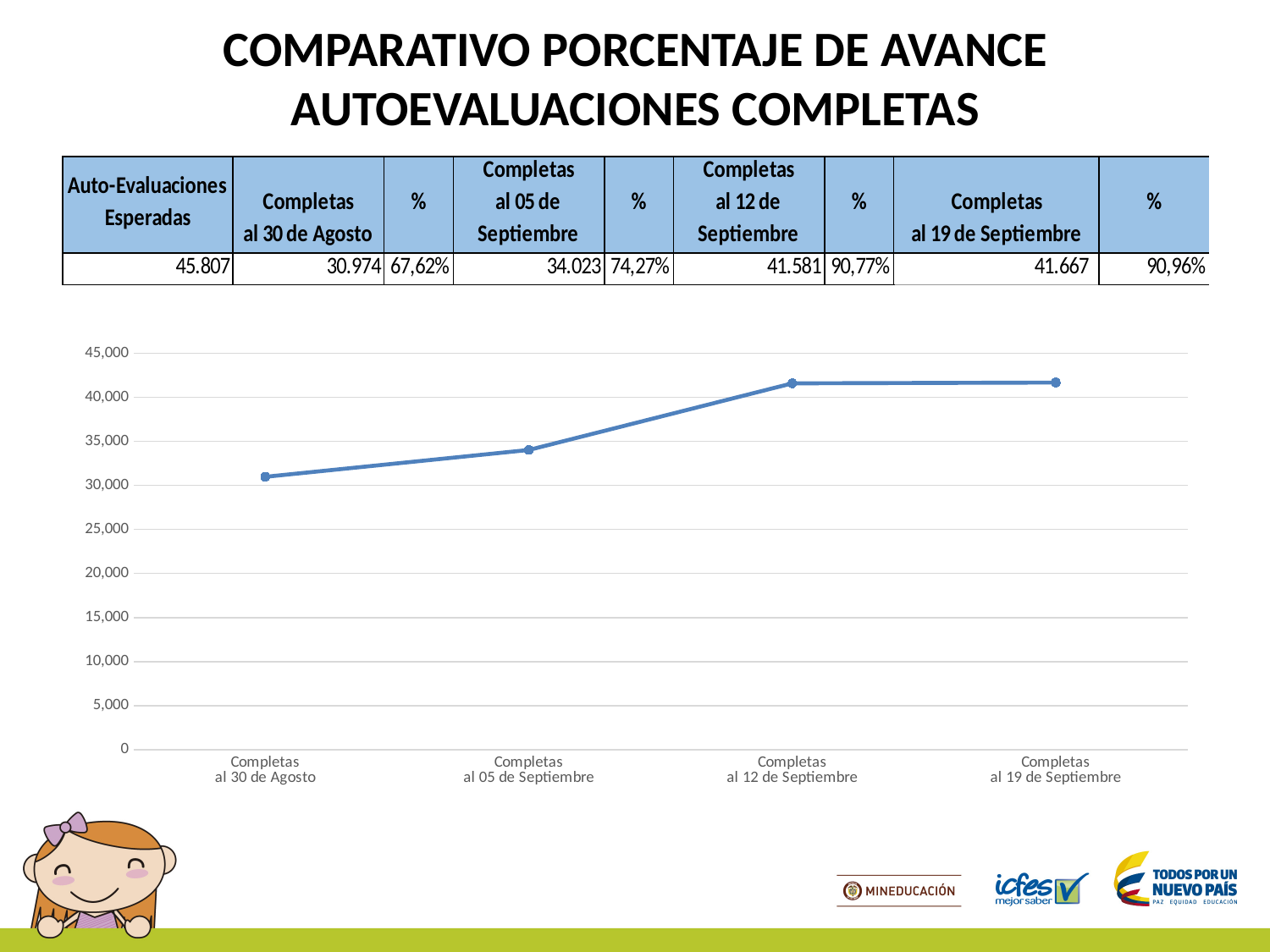
Is the value for 'Completas al 12 de Septiembre' greater or less than 40,000? greater How many data points are plotted on the line chart? 4 Is the value for 'Completas al 30 de Agosto' greater or less than 30,000? greater What is the highest value shown on the vertical axis of the line chart? 45,000 Which is larger, the value for 'Completas al 12 de Septiembre' or 'Completas al 05 de Septiembre'? Completas al 12 de Septiembre What kind of chart is shown on the slide? line chart According to the table on the slide, what is the value of 'Completas al 30 de Agosto'? 30.974 Which point on the line chart has the lowest value? Completas al 30 de Agosto Do the values on the line chart rise or fall from 'Completas al 30 de Agosto' to 'Completas al 19 de Septiembre'? rise Using the values in the table, what is the difference between 'Completas al 05 de Septiembre' and 'Completas al 30 de Agosto'? 3.049 According to the table on the slide, what is the value of 'Completas al 19 de Septiembre'? 41.667 Is the value for 'Completas al 05 de Septiembre' greater or less than 35,000? less